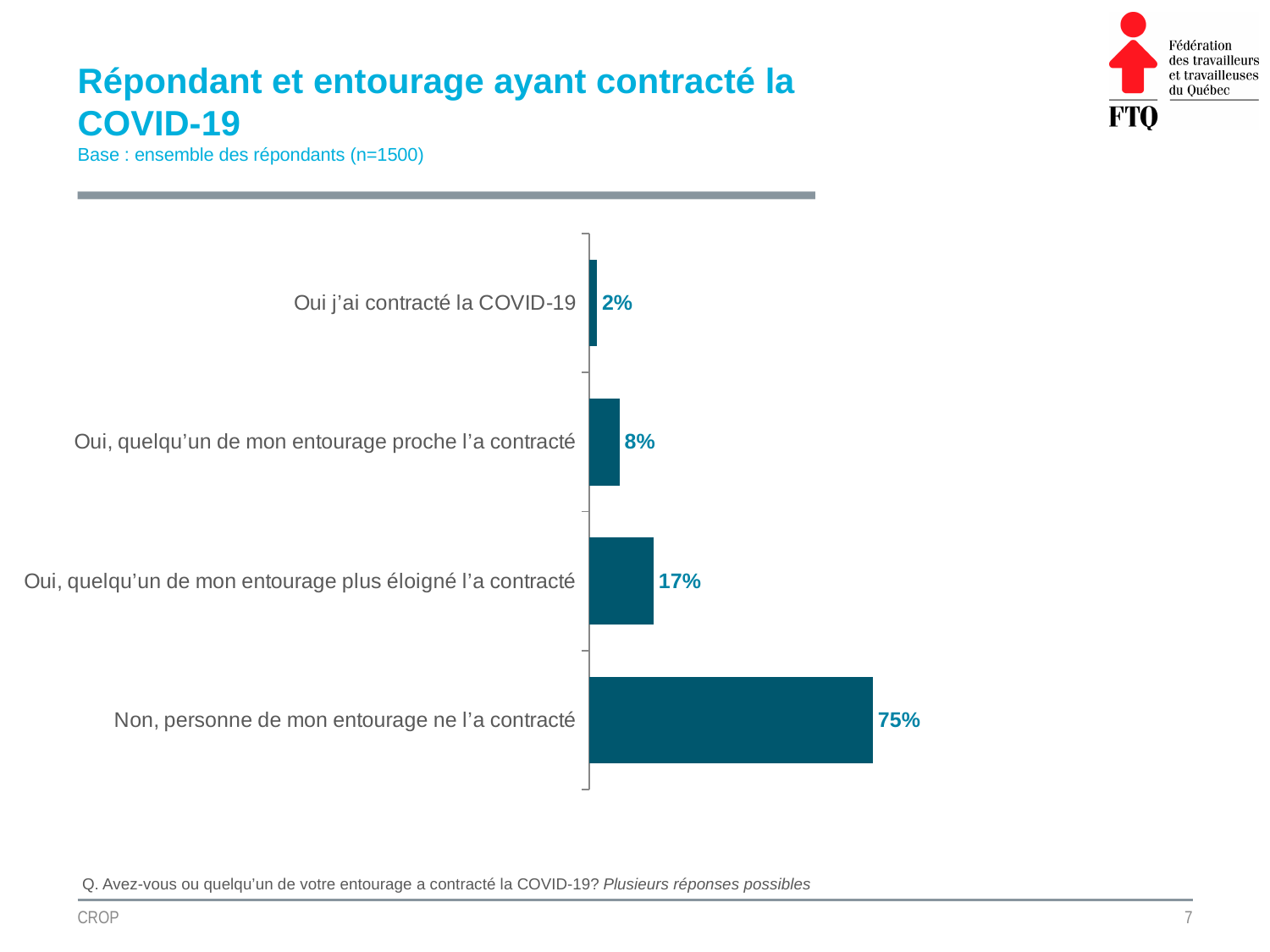
What is the difference between the values for "Oui, quelqu'un de mon entourage proche l'a contracté" and "Oui j'ai contracté la COVID-19"? 6 percentage points What is the value for "Oui, quelqu'un de mon entourage plus éloigné l'a contracté"? 17% Which is larger: the value for "Oui, quelqu'un de mon entourage plus éloigné l'a contracté" or the value for "Oui, quelqu'un de mon entourage proche l'a contracté"? Oui, quelqu'un de mon entourage plus éloigné l'a contracté What is the title of the chart on the slide? Répondant et entourage ayant contracté la COVID-19 What percentage of respondents answered "Oui j'ai contracté la COVID-19"? 2% What is the value for "Oui, quelqu'un de mon entourage proche l'a contracté"? 8% What kind of chart is shown on the slide? Bar chart Which category has the highest value? Non, personne de mon entourage ne l'a contracté What percentage of respondents answered "Non, personne de mon entourage ne l'a contracté"? 75% What is the difference between the value for "Non, personne de mon entourage ne l'a contracté" and the value for "Oui, quelqu'un de mon entourage plus éloigné l'a contracté"? 58 percentage points How many categories are shown in the chart? 4 Which category has the lowest value? Oui j'ai contracté la COVID-19